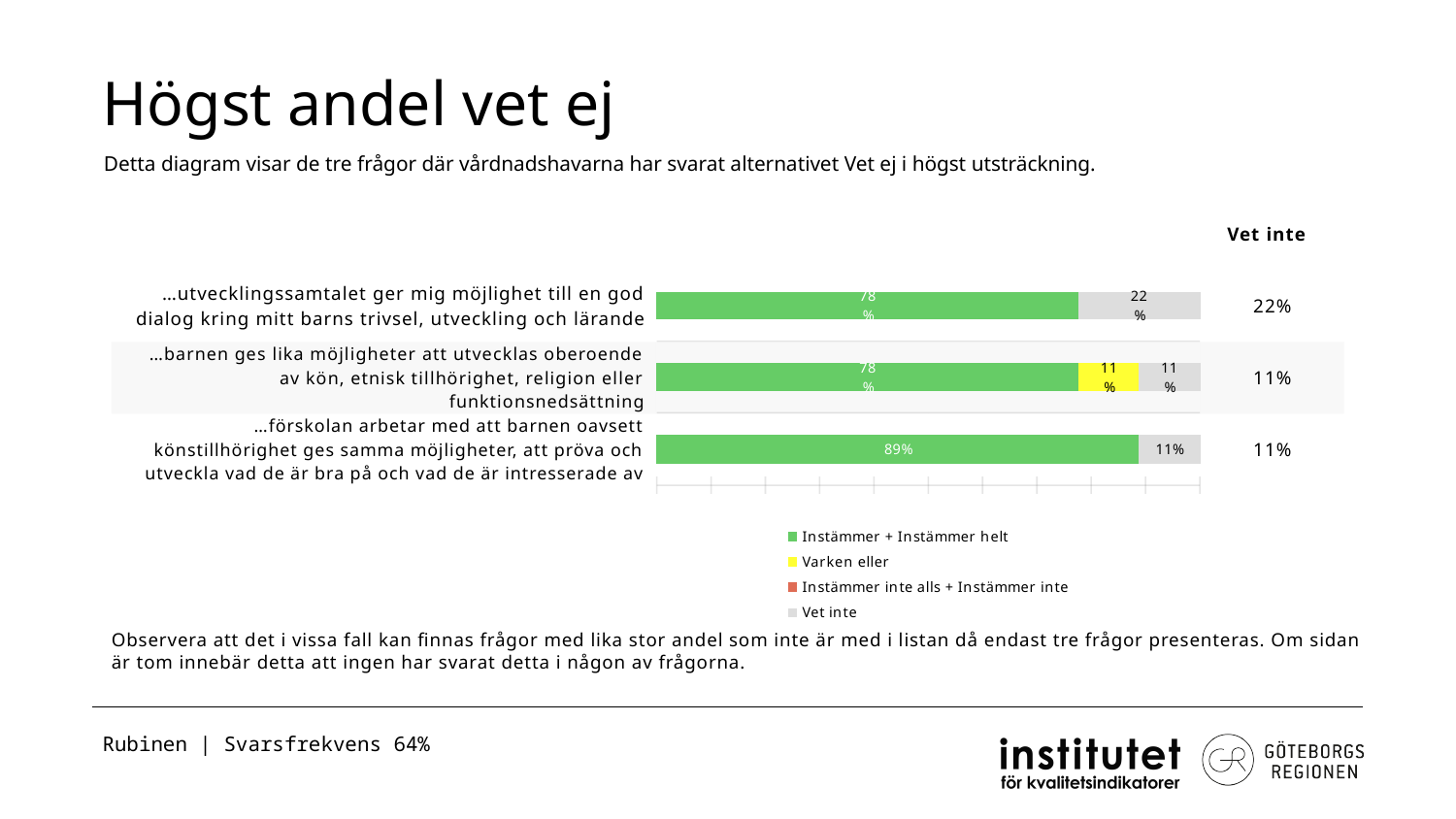
Which is larger: the 'Instämmer + Instämmer helt' value for the first category or for the third category? the third category (89%) What is the 'Instämmer + Instämmer helt' value for '…förskolan arbetar med att barnen oavsett könstillhörighet ges samma möjligheter, att pröva och utveckla vad de är bra på och vad de är intresserade av'? 89% What is the 'Vet inte' value for '…utvecklingssamtalet ger mig möjlighet till en god dialog kring mitt barns trivsel, utveckling och lärande'? 22% Which category has the highest 'Instämmer + Instämmer helt' share? …förskolan arbetar med att barnen oavsett könstillhörighet ges samma möjligheter, att pröva och utveckla vad de är bra på och vad de är intresserade av How many categories (questions) are plotted in the chart? 3 Which category has the highest 'Vet inte' share? …utvecklingssamtalet ger mig möjlighet till en god dialog kring mitt barns trivsel, utveckling och lärande What is the difference between the 'Vet inte' value for the first category (22%) and the third category (11%)? 11% How many series does the legend list? 4 What is the total of the stacked bar for '…barnen ges lika möjligheter att utvecklas oberoende av kön, etnisk tillhörighet, religion eller funktionsnedsättning'? 100% Which legend entry is shown in yellow? Varken eller What kind of chart is shown on the slide? stacked bar chart What is the 'Varken eller' value for '…barnen ges lika möjligheter att utvecklas oberoende av kön, etnisk tillhörighet, religion eller funktionsnedsättning'? 11%